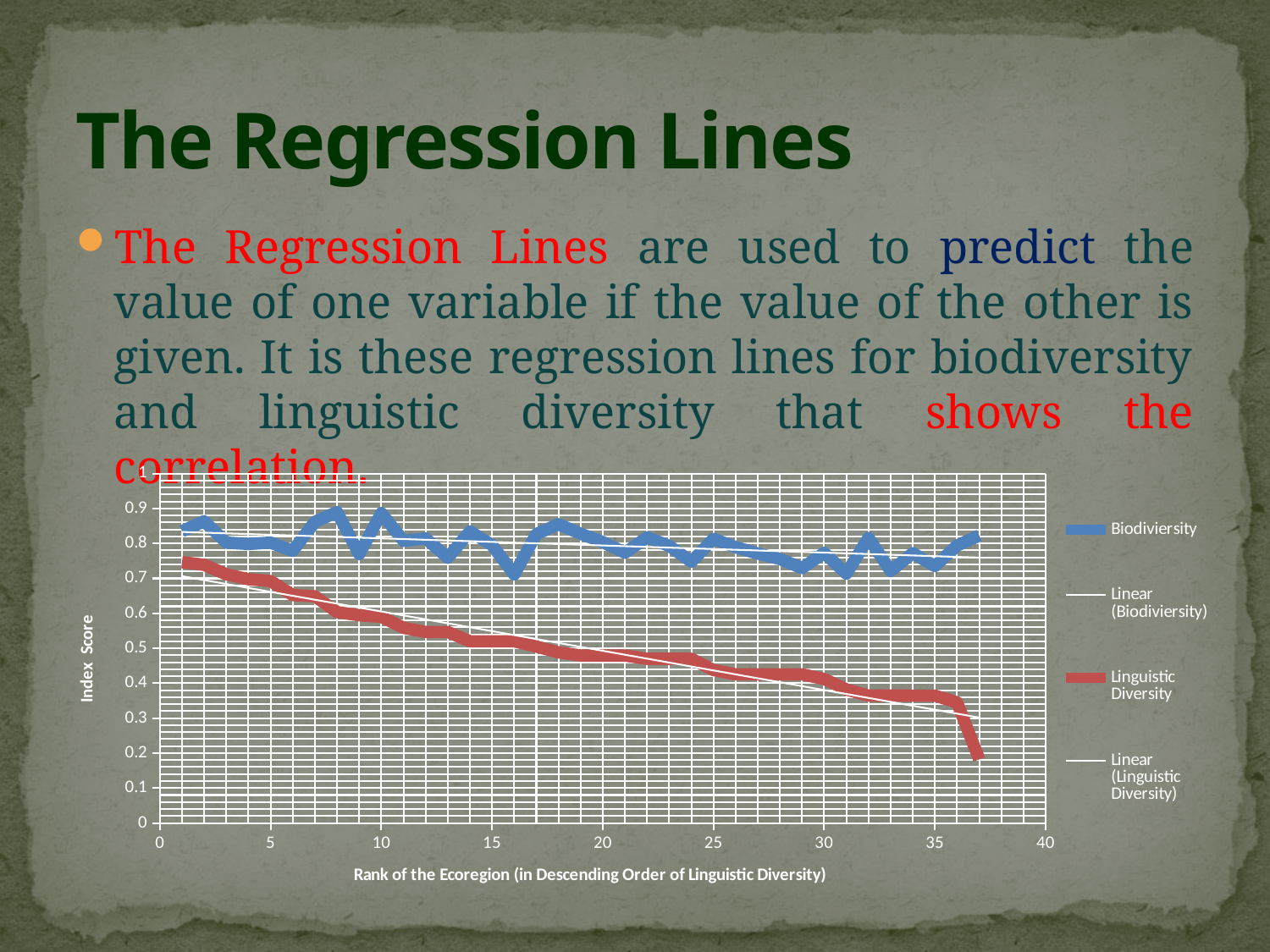
Is the Linguistic Diversity value at rank 1 greater or less than 0.7? greater At which rank does the Linguistic Diversity series reach its highest value? 1 How many entries does the chart legend list? 4 What is the title of the chart's y axis? Index Score Is the Linguistic Diversity value at rank 30 greater or less than 0.5? less What kind of chart is shown on the slide? line chart At rank 20, which series has the larger index score, Biodiversity or Linguistic Diversity? Biodiversity Is the Biodiversity value at rank 1 greater or less than 0.8? greater Which series has the higher values across the chart, Biodiversity or Linguistic Diversity? Biodiversity Does the Linguistic Diversity series rise or fall as the rank of the ecoregion increases along the x axis? fall What colour is used for the Linguistic Diversity series? red